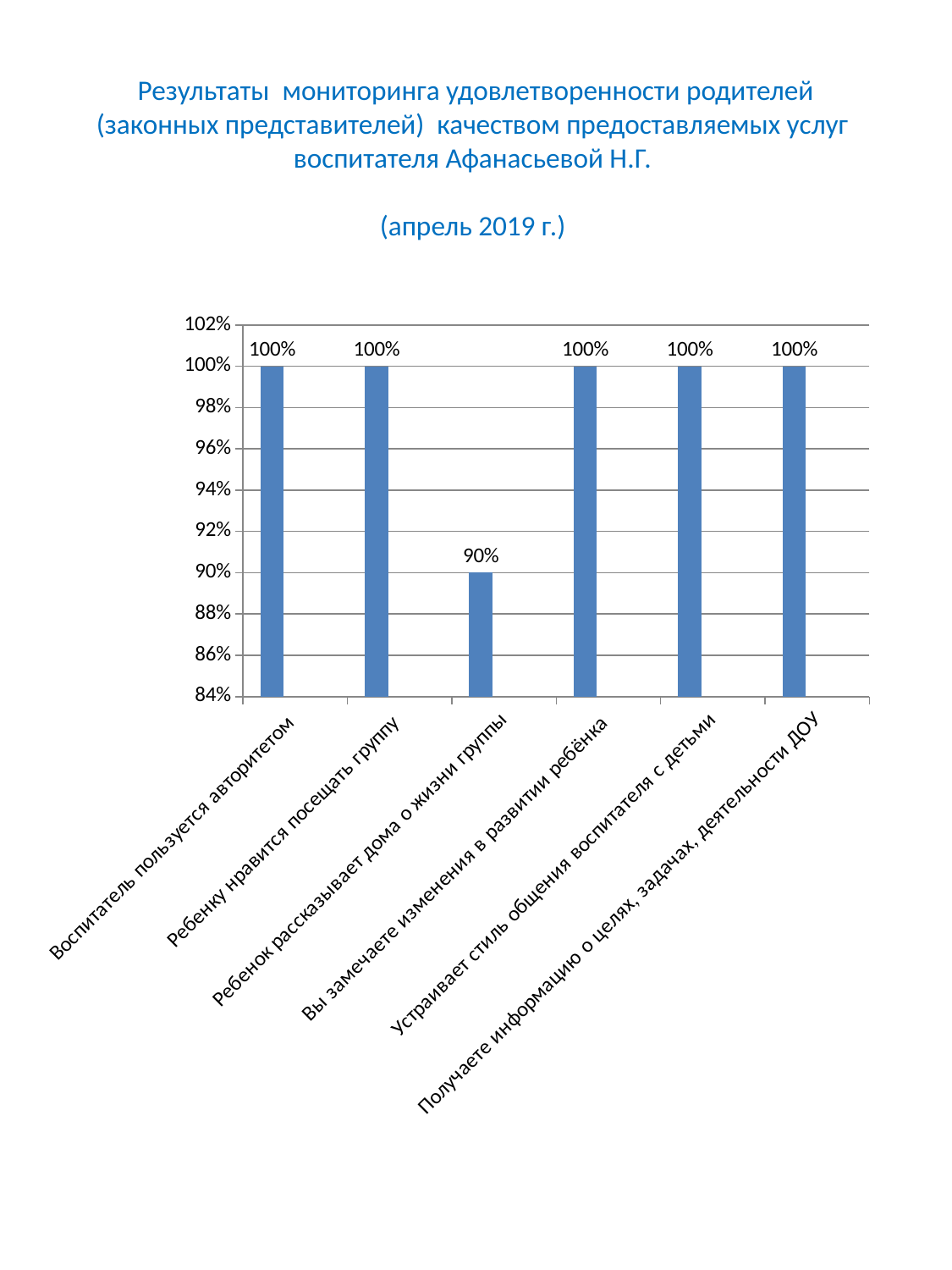
What month and year are given in the slide title? апрель 2019 г. What is the difference between the value for "Ребенку нравится посещать группу" and the value for "Ребенок рассказывает дома о жизни группы"? 10% How many categories are shown on the chart? 6 How many categories have a value of 100%? 5 Which category has the lowest value? Ребенок рассказывает дома о жизни группы What is the value for "Ребенок рассказывает дома о жизни группы"? 90% What is the value for "Получаете информацию о целях, задачах, деятельности ДОУ"? 100% Is the value for "Ребенок рассказывает дома о жизни группы" greater or less than 94%? less What is the highest value shown on the vertical axis? 102% What kind of chart is shown on the slide? bar chart What is the value for "Воспитатель пользуется авторитетом"? 100% Which is larger: the value for "Вы замечаете изменения в развитии ребёнка" or the value for "Ребенок рассказывает дома о жизни группы"? Вы замечаете изменения в развитии ребёнка